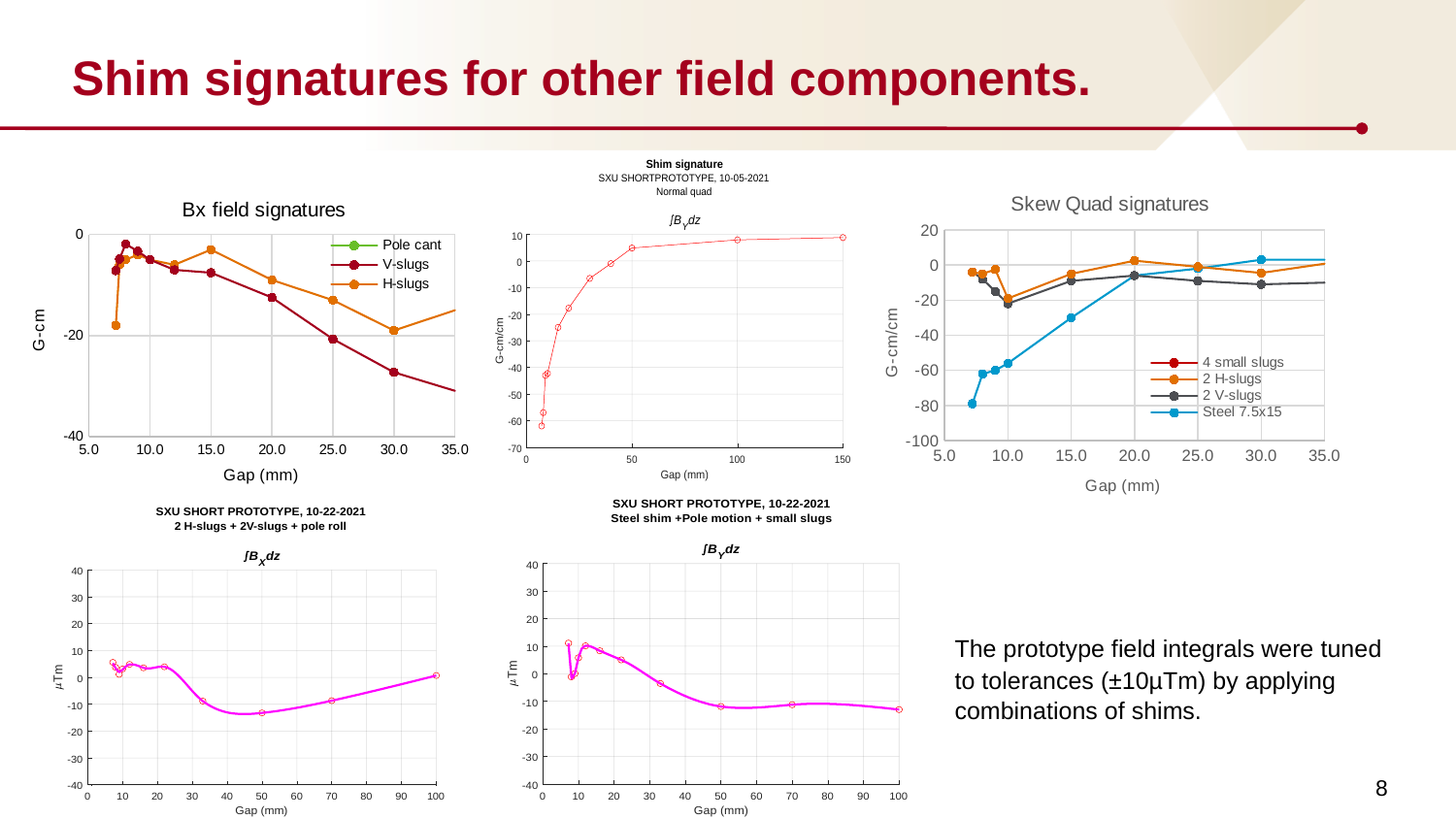
In the bottom-middle chart (Steel shim + Pole motion + small slugs, ∫By dz), is the value at a gap of 100 mm greater or less than 0? less In the Skew Quad signatures chart, is the value for Steel 7.5x15 at a gap of about 7 mm greater or less than -60? less In the Normal quad ∫By dz chart (top middle), do the values rise or fall as the gap increases? rise What is the y-axis unit of the bottom-left ∫Bx dz chart? µTm In the Normal quad ∫By dz chart (top middle), is the value at a gap of 100 mm greater or less than 0? greater In the Skew Quad signatures chart, which series has the lowest value at the smallest gap (around 7 mm)? Steel 7.5x15 In the Bx field signatures chart, how many series does the legend list? 3 What kind of chart is the Bx field signatures chart? line chart In the Skew Quad signatures chart, how many series does the legend list? 4 In the Bx field signatures chart, at a gap of 30.0 mm, which series has the larger value, V-slugs or H-slugs? H-slugs In the Bx field signatures chart, do the V-slugs values rise or fall as the gap increases from 10.0 to 35.0 mm? fall